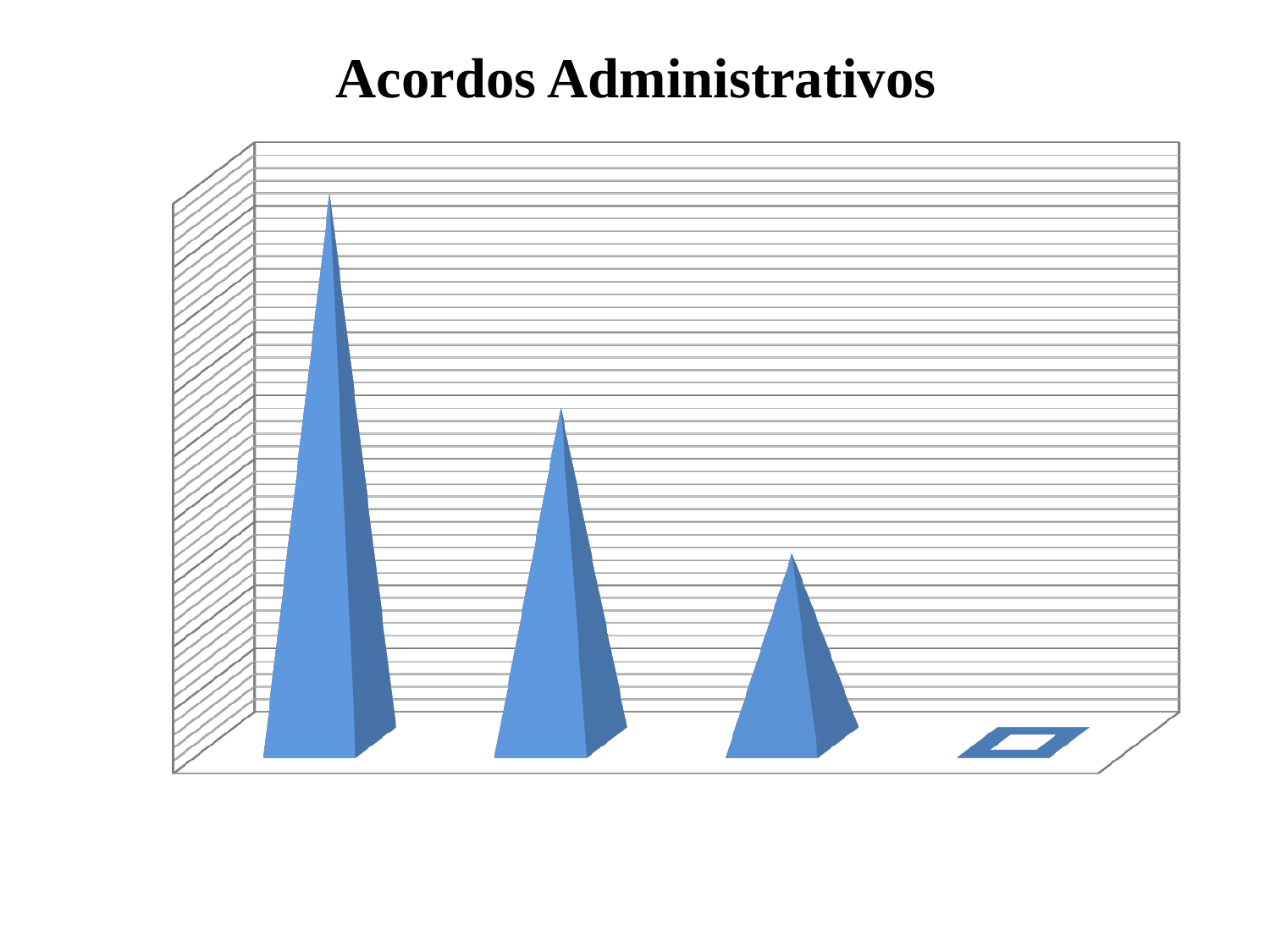
What kind of chart is shown on the slide? bar chart How many bars (categories) are plotted in the chart? 4 What colour are the bars in the chart? blue What is the title of the chart on the slide? Acordos Administrativos Which is larger, the first bar from the left or the second bar from the left? the first bar Which is larger, the third bar from the left or the fourth bar from the left? the third bar Do the bar values rise or fall from left to right across the chart? fall Which bar is the tallest in the chart: the first, second, third or fourth from the left? the first Which bar is the lowest in the chart: the first, second, third or fourth from the left? the fourth Which is larger, the second bar from the left or the third bar from the left? the second bar